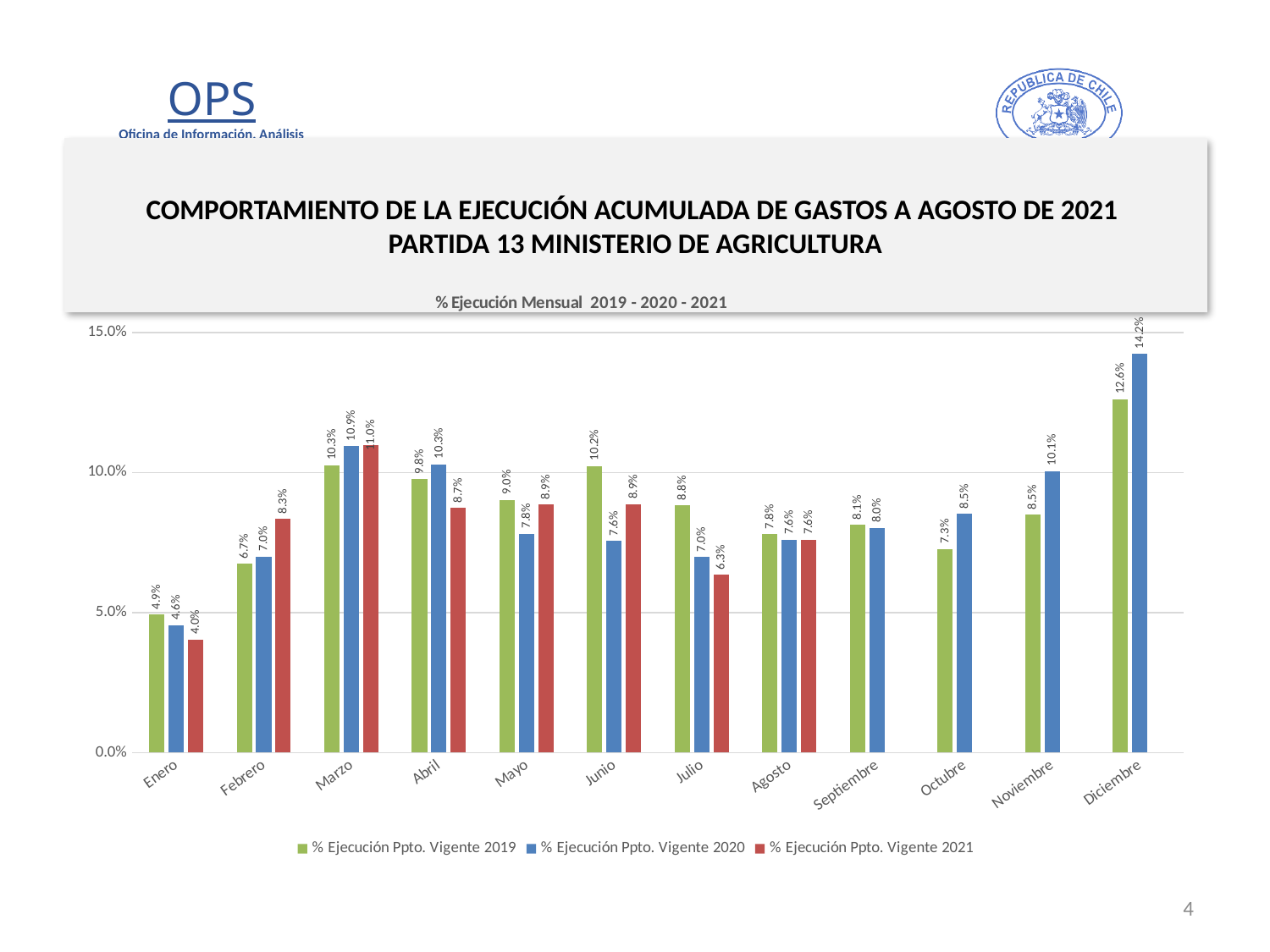
What is the value for % Ejecución Ppto. Vigente 2020 in Diciembre? 14.2% How many series does the legend list? 3 What is the value for % Ejecución Ppto. Vigente 2019 in Junio? 10.2% What is the title of the chart? % Ejecución Mensual 2019 - 2020 - 2021 Is the value for % Ejecución Ppto. Vigente 2020 in Noviembre greater or less than 10.0%? greater Which month has the highest value for % Ejecución Ppto. Vigente 2019? Diciembre What is the difference between the 2020 and 2019 values in Diciembre? 1.6% Which month has the lowest value for % Ejecución Ppto. Vigente 2021? Enero What kind of chart is shown on the slide? Bar chart In Julio, which series has the larger value: % Ejecución Ppto. Vigente 2019 or % Ejecución Ppto. Vigente 2021? % Ejecución Ppto. Vigente 2019 What is the value for % Ejecución Ppto. Vigente 2021 in Marzo? 11.0% How many months are shown on the x axis? 12